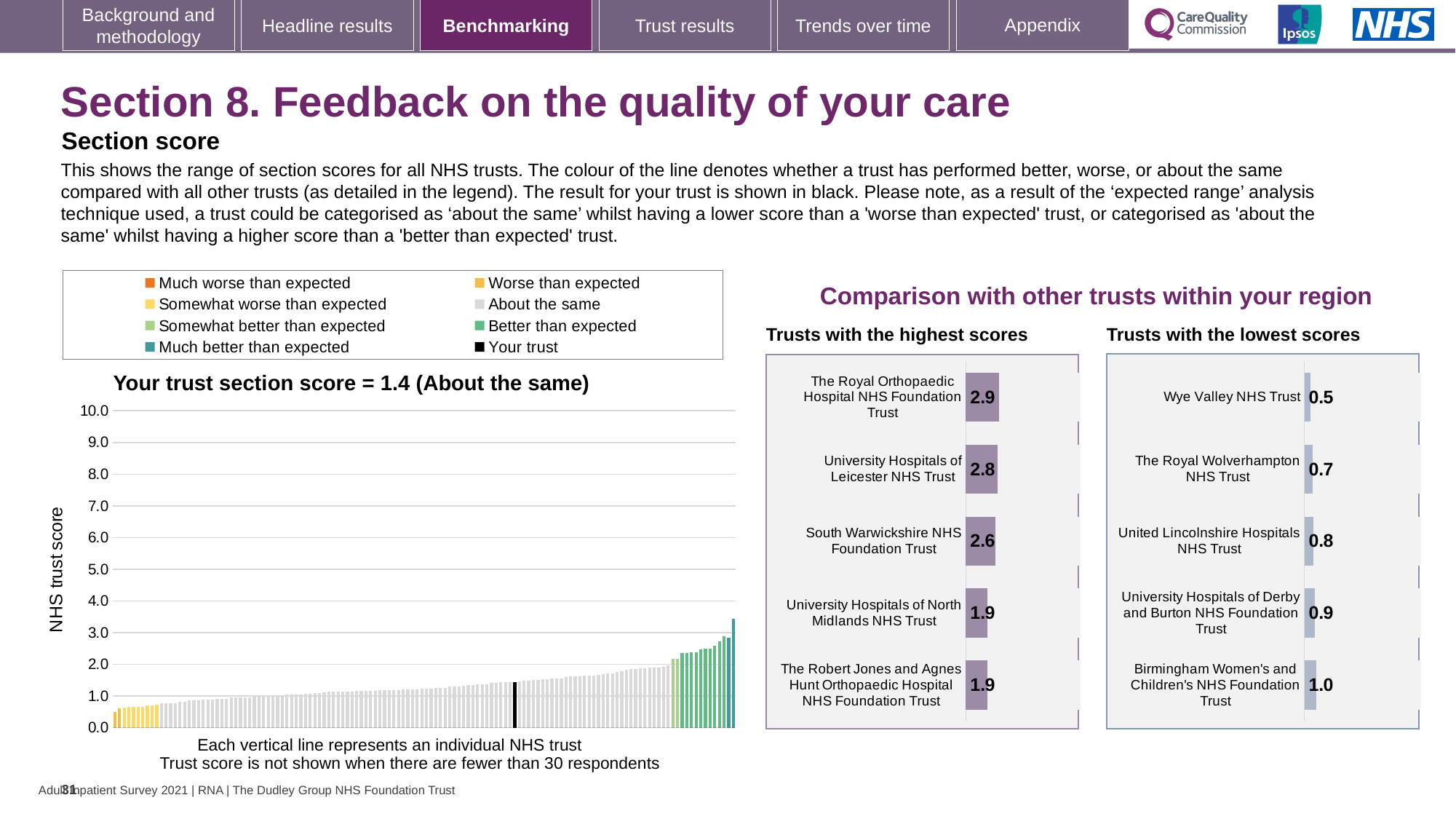
On the 'Your trust section score' chart, what is the highest value shown on the y axis? 10.0 On the 'Your trust section score' chart, is the value for your trust greater or less than 2.0? less On the 'Trusts with the lowest scores' chart, how many trusts are shown? 5 On the 'Your trust section score' chart, what is the section score for your trust? 1.4 What kind of chart is the 'Your trust section score' chart? Bar chart On the 'Your trust section score' chart, do the trust scores rise or fall from left to right? Rise On the 'Trusts with the lowest scores' chart, which has the larger score: The Royal Wolverhampton NHS Trust or United Lincolnshire Hospitals NHS Trust? United Lincolnshire Hospitals NHS Trust On the 'Trusts with the highest scores' chart, which trust has the highest score? The Royal Orthopaedic Hospital NHS Foundation Trust On the 'Your trust section score' chart, how many entries does the legend list? 8 On the 'Trusts with the highest scores' chart, what is the difference between the scores of The Royal Orthopaedic Hospital NHS Foundation Trust and South Warwickshire NHS Foundation Trust? 0.3 On the 'Trusts with the lowest scores' chart, which trust has the lowest score? Wye Valley NHS Trust On the 'Trusts with the highest scores' chart, what is the score for University Hospitals of Leicester NHS Trust? 2.8